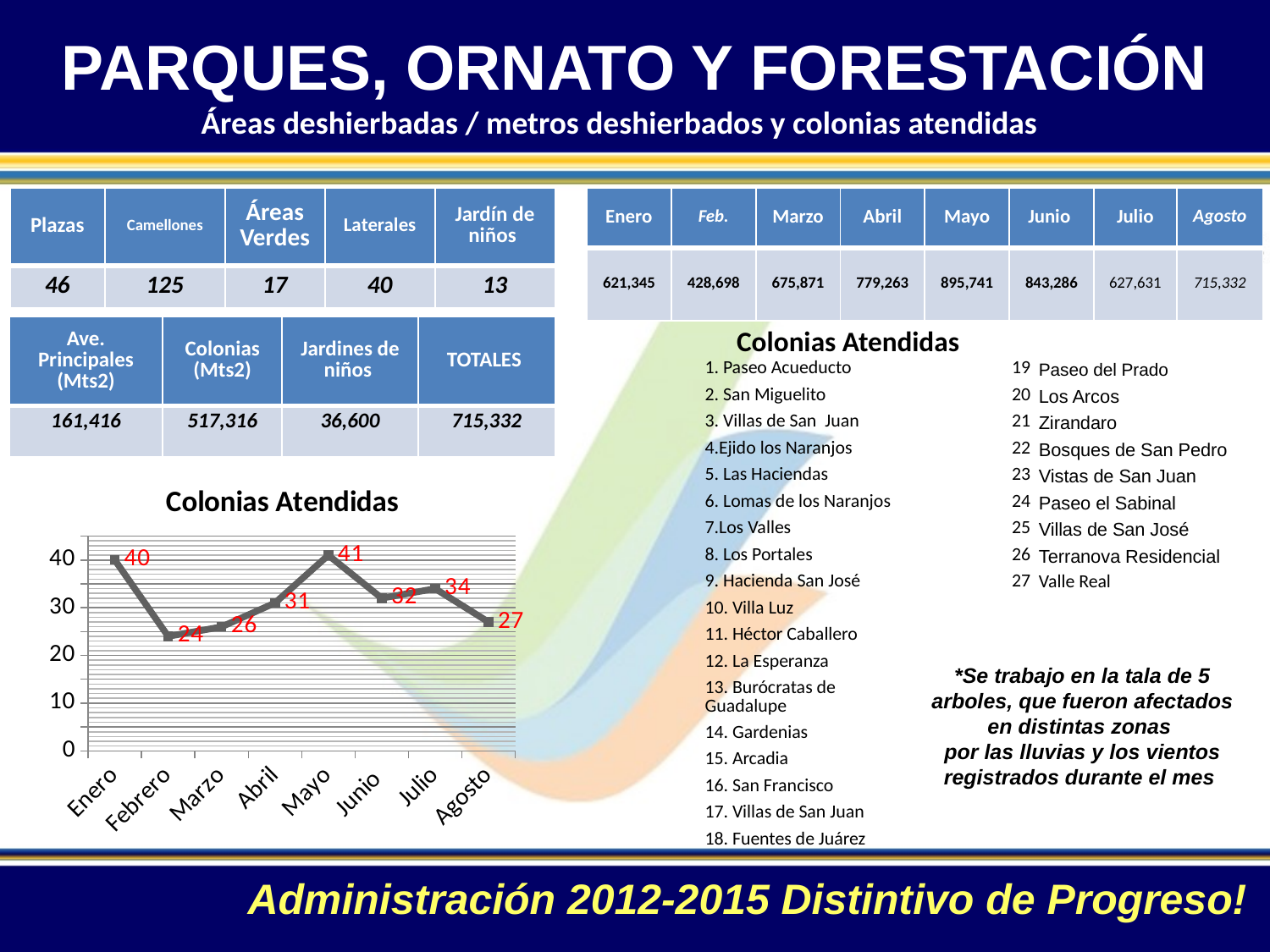
In the "Colonias Atendidas" chart, which month has the lowest value? Febrero In the "Colonias Atendidas" chart, which month has the highest value? Mayo How many months are plotted in the "Colonias Atendidas" chart? 8 In the "Colonias Atendidas" chart, what is the difference between the values for Mayo and Febrero? 17 In the "Colonias Atendidas" chart, is the value for Abril greater or less than 30? greater In the "Colonias Atendidas" chart, what is the value for Febrero? 24 In the "Colonias Atendidas" chart, what is the value for Agosto? 27 In the "Colonias Atendidas" chart, which is larger, the value for Julio or the value for Junio? Julio In the "Colonias Atendidas" chart, does the value rise or fall from Enero to Febrero? fall In the "Colonias Atendidas" chart, what is the value for Mayo? 41 In the "Colonias Atendidas" chart, what is the value for Enero? 40 What type of chart is shown under the title "Colonias Atendidas"? line chart